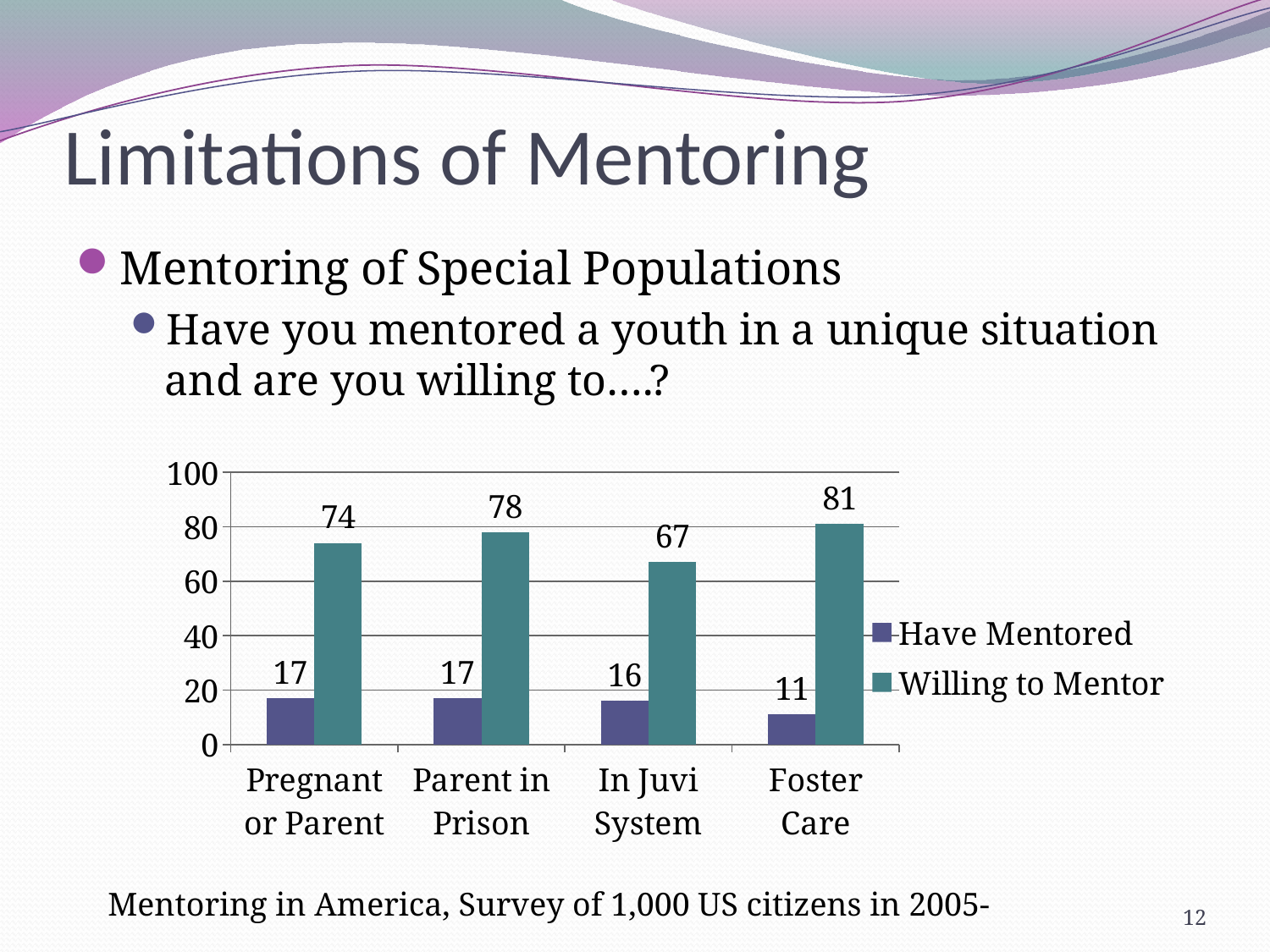
How many categories are shown on the x axis? 4 Which is larger, the Willing to Mentor value for Parent in Prison or for In Juvi System? Parent in Prison Which series is shown in teal in the legend? Willing to Mentor How many series does the legend list? 2 What is the value for Willing to Mentor for Foster Care? 81 Which category has the lowest Have Mentored value? Foster Care What is the difference between Willing to Mentor and Have Mentored for Parent in Prison? 61 What is the value for Willing to Mentor for Pregnant or Parent? 74 What kind of chart is shown on the slide? Bar chart What is the value for Have Mentored for In Juvi System? 16 Which category has the highest Willing to Mentor value? Foster Care Is the Willing to Mentor value for In Juvi System greater or less than 60? greater